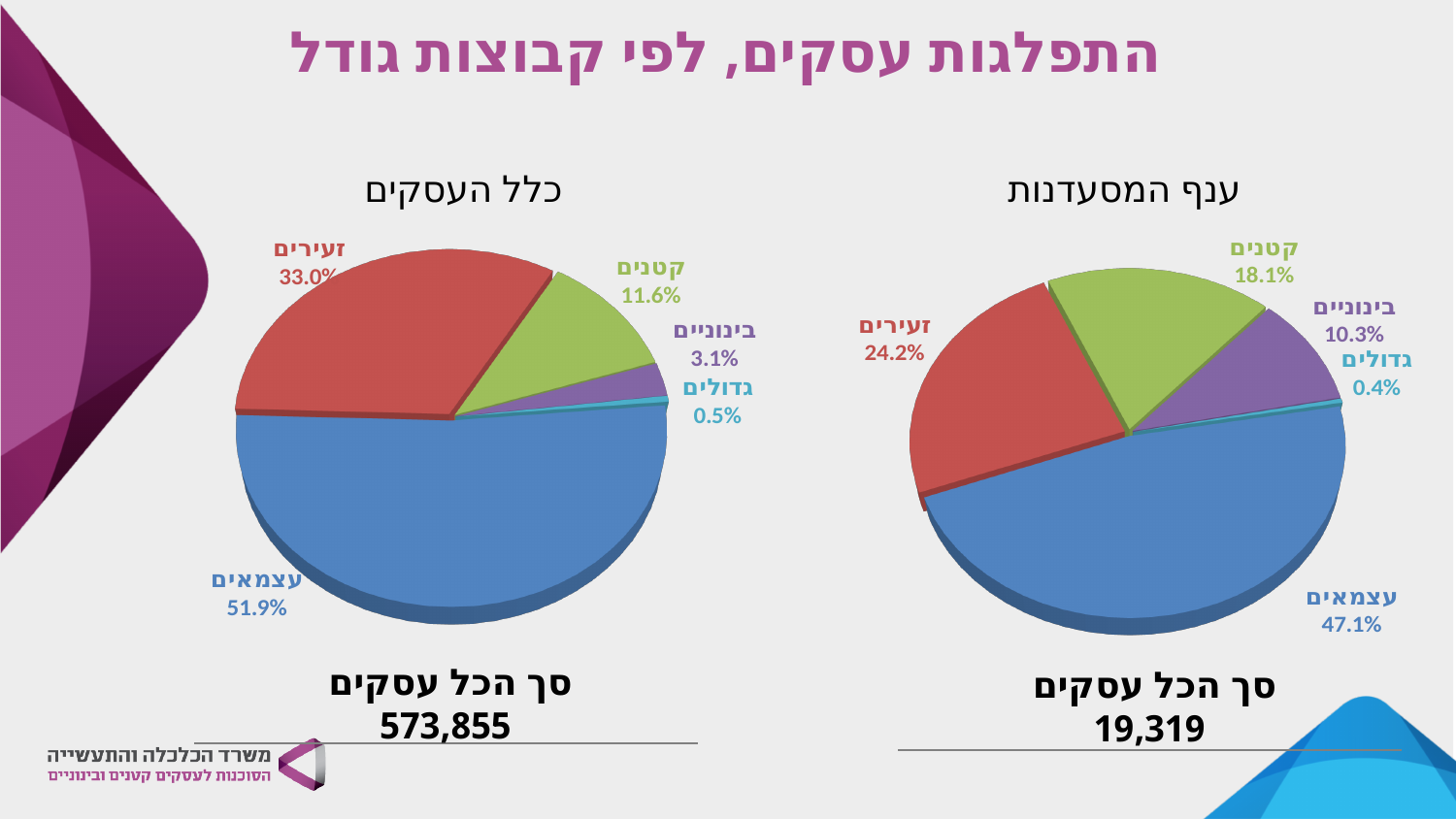
In the pie chart titled "ענף המסעדנות", what is the share for "בינוניים"? 10.3% What type of chart is used on the left side of the slide, titled "כלל העסקים"? Pie chart In the pie chart titled "ענף המסעדנות", what is the share for "קטנים"? 18.1% How many slices does the pie chart titled "ענף המסעדנות" have? 5 In the pie chart titled "כלל העסקים", what is the share for "עצמאים"? 51.9% In the pie chart titled "ענף המסעדנות", what is the difference between the shares of "עצמאים" and "זעירים"? 22.9% In the pie chart titled "כלל העסקים", which category has the largest slice? עצמאים In the pie chart titled "כלל העסקים", what is the difference between the shares of "זעירים" and "קטנים"? 21.4% In the pie chart titled "ענף המסעדנות", which category has the smallest slice? גדולים What is the total number of businesses ("סך הכל עסקים") shown under the "כלל העסקים" chart? 573,855 What is the total number of businesses ("סך הכל עסקים") shown under the "ענף המסעדנות" chart? 19,319 Which is larger: the share of "זעירים" in the "כלל העסקים" chart or in the "ענף המסעדנות" chart? כלל העסקים